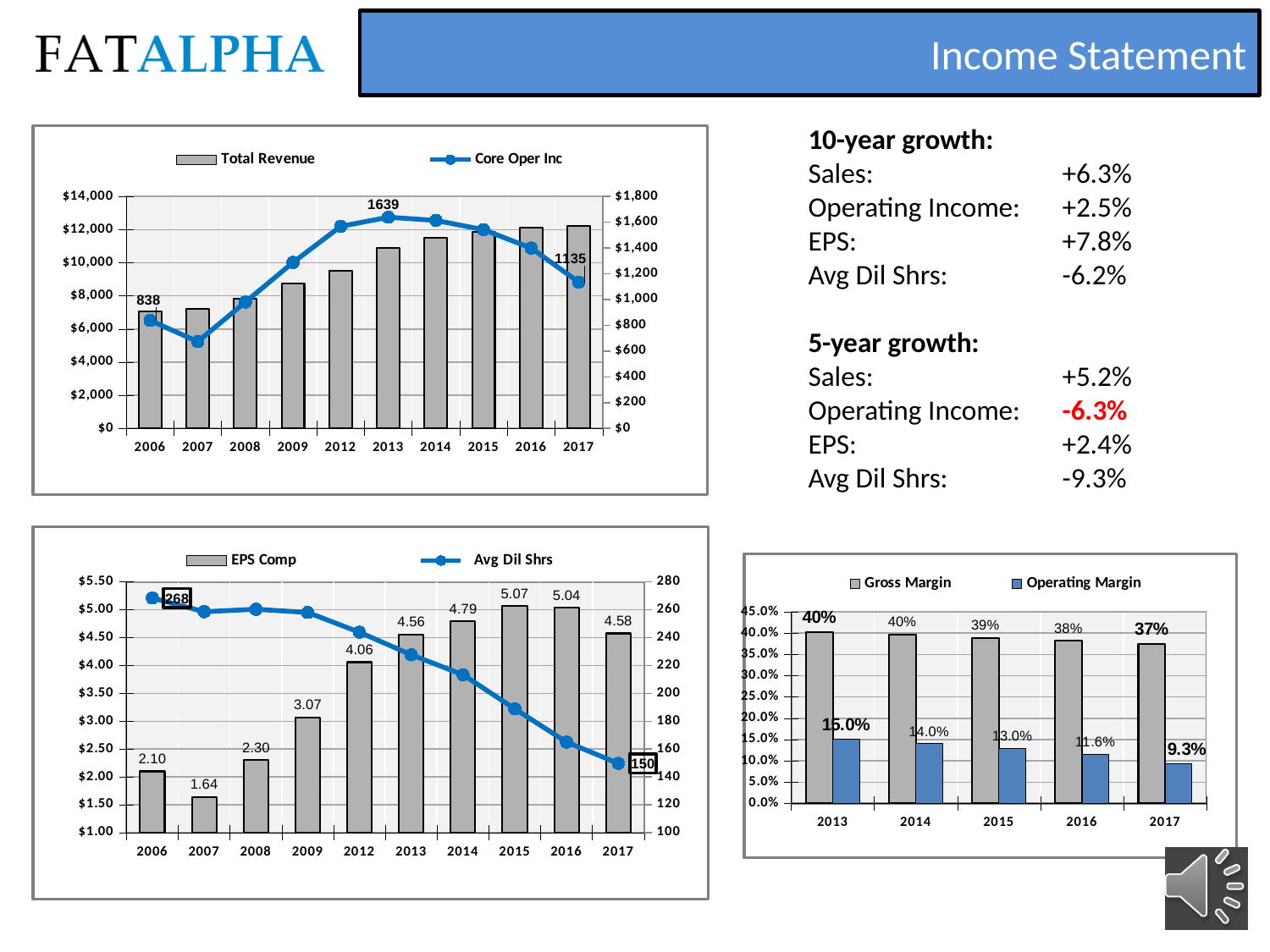
In the Gross Margin / Operating Margin chart, how many series does the legend list? 2 In the EPS Comp / Avg Dil Shrs chart, what is the EPS Comp value for 2015? 5.07 In the Total Revenue / Core Oper Inc chart, what is the Core Oper Inc value labelled for 2013? 1639 In the EPS Comp / Avg Dil Shrs chart, which year has the lowest EPS Comp? 2007 In the Total Revenue / Core Oper Inc chart, how many years are shown on the x axis? 10 In the Total Revenue / Core Oper Inc chart, is the Total Revenue for 2006 greater or less than $8,000? less In the Total Revenue / Core Oper Inc chart, what is the Core Oper Inc value labelled for 2006? 838 In the Gross Margin / Operating Margin chart, what is the Operating Margin for 2016? 11.6% In the EPS Comp / Avg Dil Shrs chart, what is the difference between the EPS Comp for 2015 and 2007? 3.43 In the EPS Comp / Avg Dil Shrs chart, what is the Avg Dil Shrs value labelled for 2017? 150 In the EPS Comp / Avg Dil Shrs chart, does Avg Dil Shrs rise or fall from 2006 to 2017? fall In the Gross Margin / Operating Margin chart, which year has the lowest Operating Margin? 2017